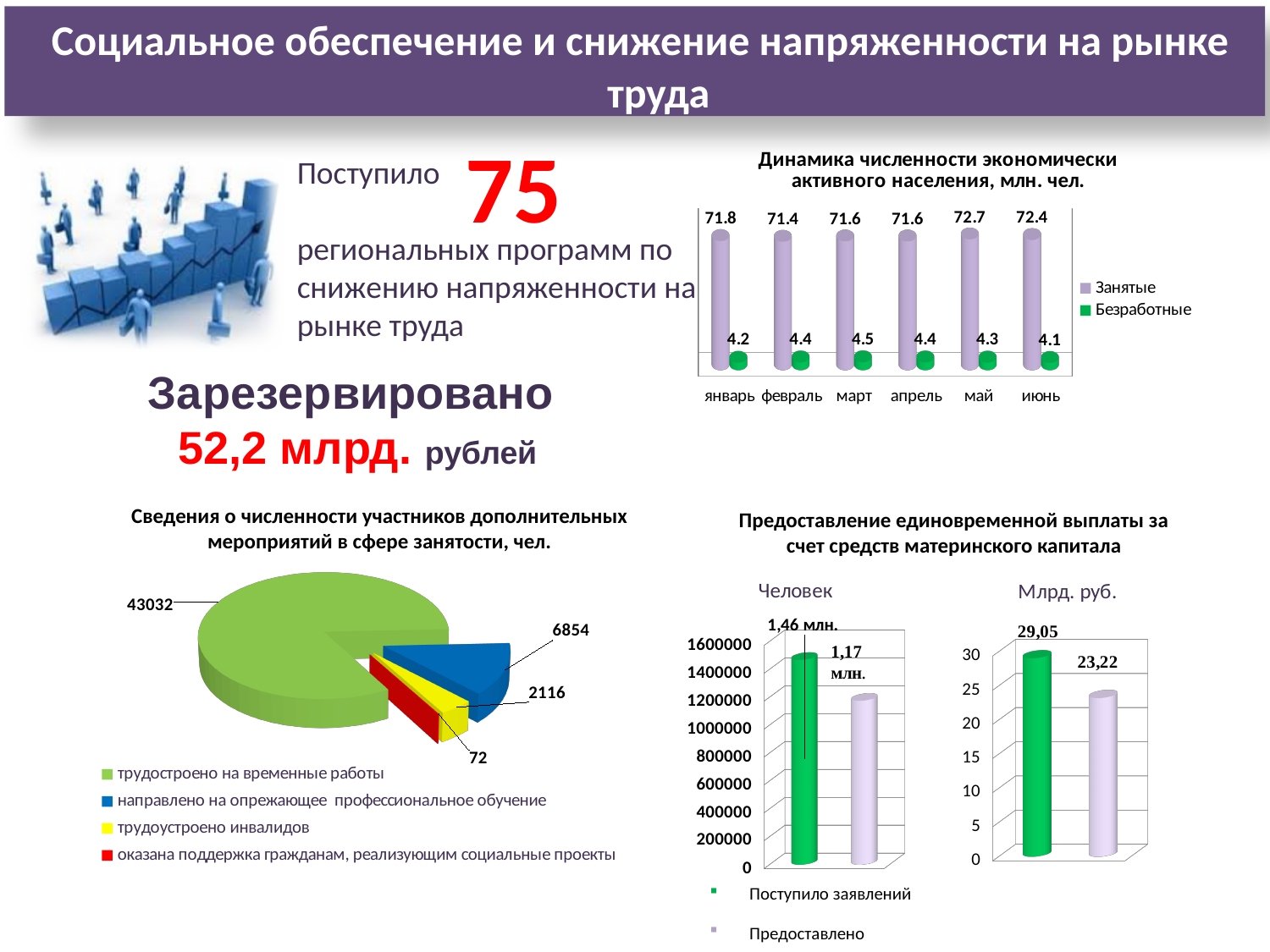
In the 'Человек' chart under 'Предоставление единовременной выплаты за счет средств материнского капитала', which is larger: Поступило заявлений or Предоставлено? Поступило заявлений In the pie chart 'Сведения о численности участников дополнительных мероприятий в сфере занятости, чел.', what is the value for 'направлено на опрежающее профессиональное обучение'? 6854 In the chart 'Динамика численности экономически активного населения, млн. чел.', how many series does the legend list? 2 In the chart 'Динамика численности экономически активного населения, млн. чел.', what is the value for Безработные in март? 4.5 In the pie chart 'Сведения о численности участников дополнительных мероприятий в сфере занятости, чел.', what is the value of the smallest slice? 72 In the pie chart 'Сведения о численности участников дополнительных мероприятий в сфере занятости, чел.', which category has the largest slice? трудостроено на временные работы In the chart 'Динамика численности экономически активного населения, млн. чел.', what is the difference between Занятые in май and Занятые in январь? 0.9 In the 'Млрд. руб.' chart under 'Предоставление единовременной выплаты за счет средств материнского капитала', what is the value for Предоставлено? 23,22 In the chart 'Динамика численности экономически активного населения, млн. чел.', what is the value for Занятые in май? 72.7 In the chart 'Динамика численности экономически активного населения, млн. чел.', which month has the lowest value for Безработные? июнь In the chart 'Динамика численности экономически активного населения, млн. чел.', how many months are shown on the x axis? 6 In the chart 'Динамика численности экономически активного населения, млн. чел.', which month has the highest value for Занятые? май